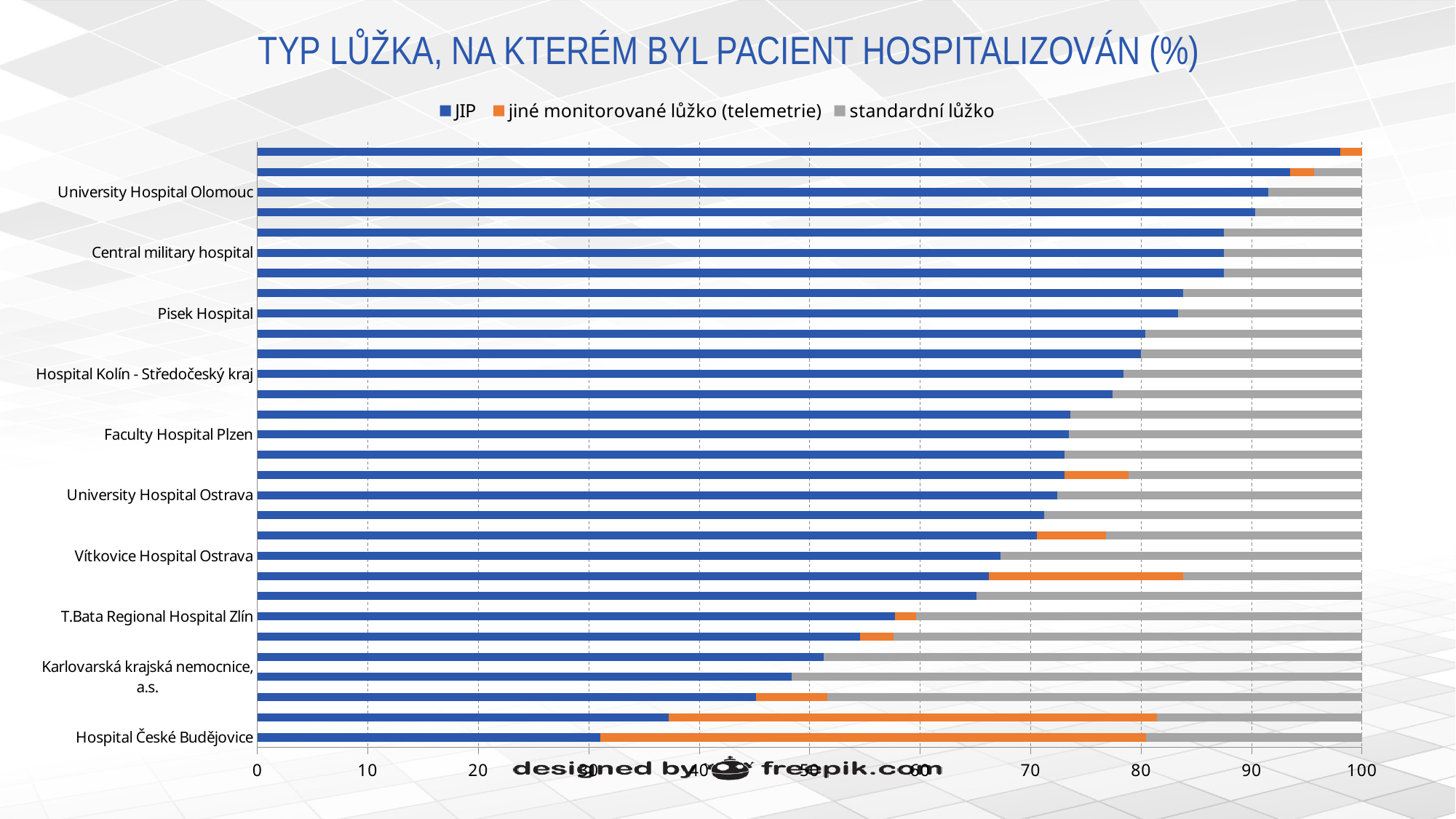
What is the title of the chart? TYP LŮŽKA, NA KTERÉM BYL PACIENT HOSPITALIZOVÁN (%) Is the JIP value for University Hospital Olomouc greater or less than 90? greater What kind of chart is shown on the slide? Stacked horizontal bar chart Is the JIP value for Faculty Hospital Plzen greater or less than 70? greater Is the JIP value for Karlovarská krajská nemocnice, a.s. greater or less than 50? less How many series does the legend list? 3 What are the three series named in the legend? JIP, jiné monitorované lůžko (telemetrie), standardní lůžko Which has the larger JIP share, Hospital České Budějovice or University Hospital Olomouc? University Hospital Olomouc Do the JIP values rise or fall going from the top bar to the bottom bar of the chart? fall